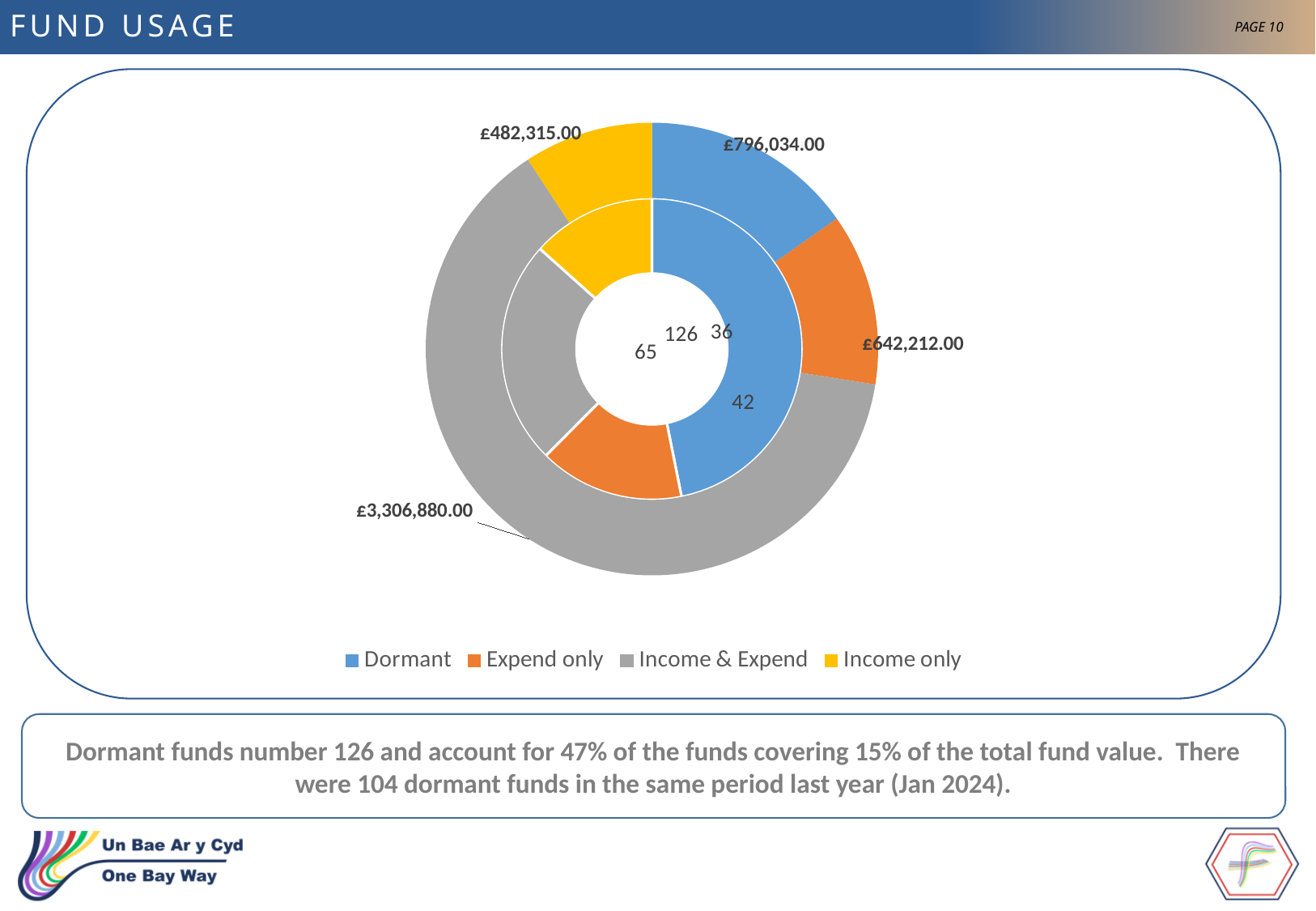
What kind of chart is shown on the slide? Doughnut (pie) chart How many Dormant funds are shown on the inner ring? 126 How many categories does the legend list? 4 Which has the larger fund value, Expend only or Income only? Expend only What is the fund value shown for Dormant on the outer ring? £796,034.00 What colour represents Income & Expend in the chart? Grey Which category has the highest fund value? Income & Expend Which category has the lowest fund value? Income only What is the fund value shown for Income & Expend? £3,306,880.00 What is the difference between the Income & Expend fund value and the Dormant fund value? £2,510,846.00 What is the fund value shown for Expend only? £642,212.00 What is the fund value shown for Income only? £482,315.00